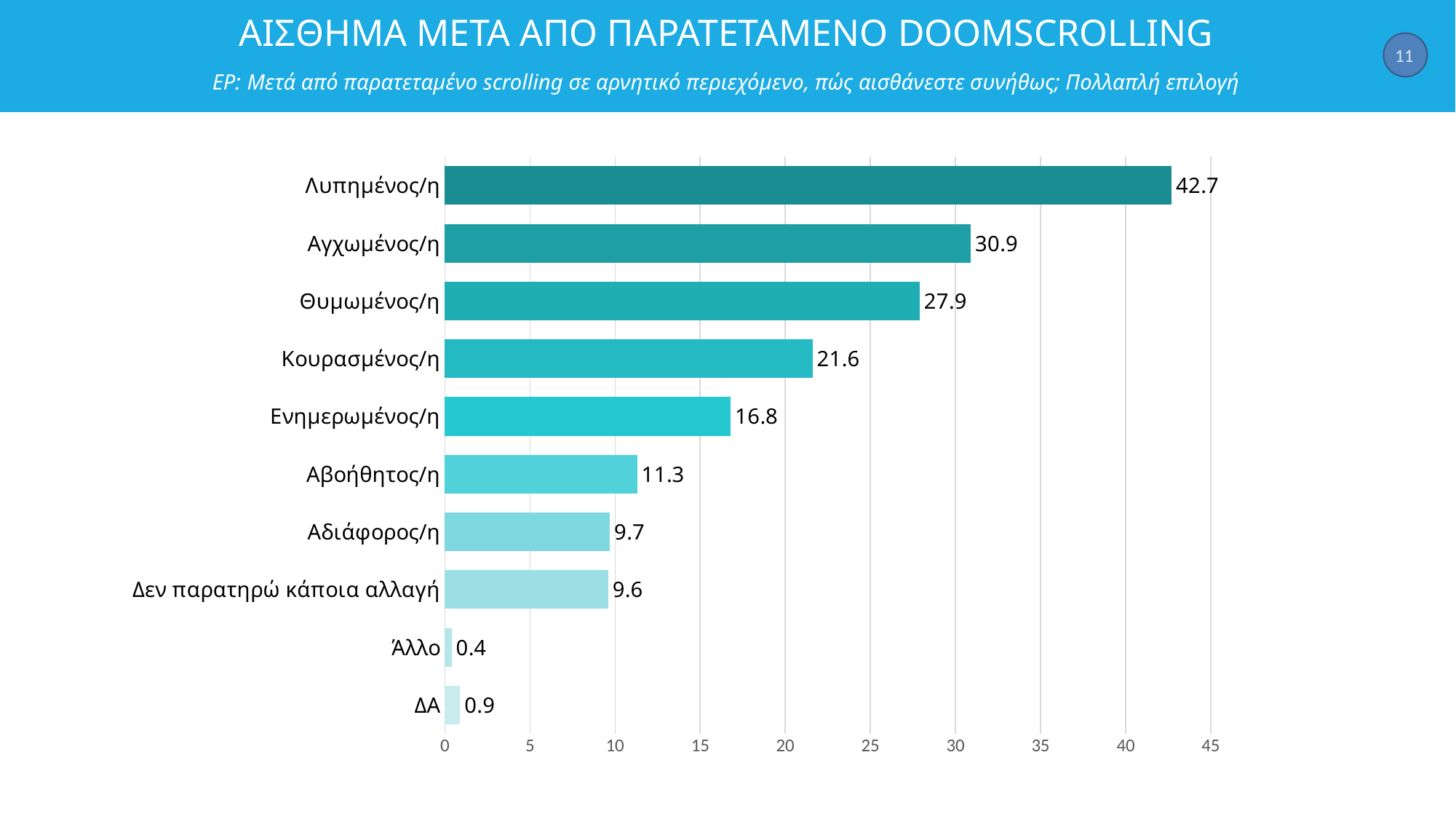
What kind of chart is shown on the slide? bar chart What is the difference between the values for Λυπημένος/η and Αγχωμένος/η? 11.8 What is the value for Δεν παρατηρώ κάποια αλλαγή? 9.6 What is the value for Λυπημένος/η? 42.7 Which category has the lowest value? Άλλο How many categories are shown in the chart? 10 What is the title of the slide? ΑΙΣΘΗΜΑ ΜΕΤΑ ΑΠΟ ΠΑΡΑΤΕΤΑΜΕΝΟ DOOMSCROLLING Which is larger, the value for Αβοήθητος/η or the value for Αδιάφορος/η? Αβοήθητος/η Which category has the highest value? Λυπημένος/η What is the value for Κουρασμένος/η? 21.6 What is the difference between the values for Θυμωμένος/η and Ενημερωμένος/η? 11.1 Is the value for Αγχωμένος/η greater or less than 30? greater